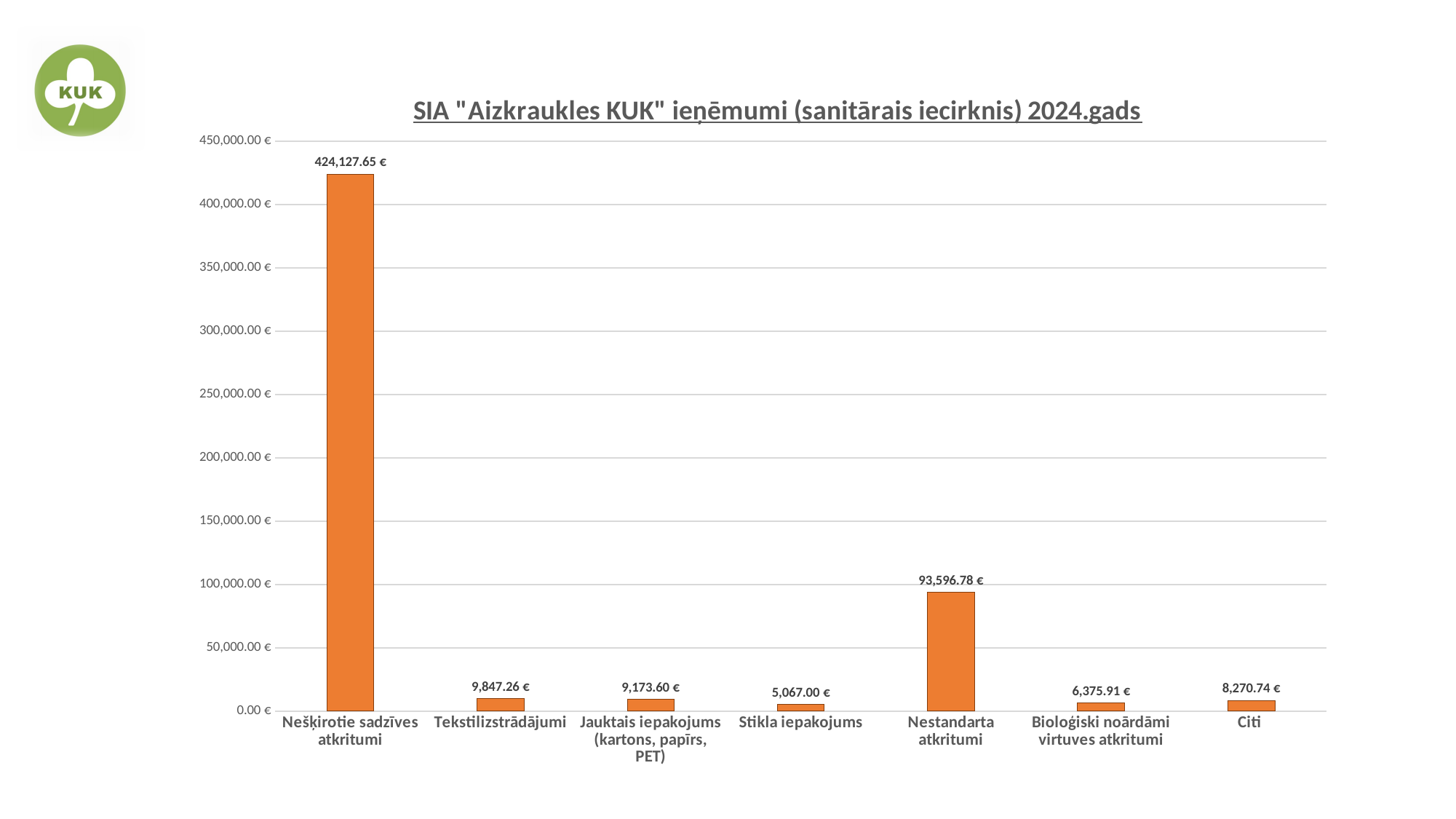
Is the value for Nestandarta atkritumi greater or less than 100,000.00 €? less How many categories are shown in the chart? 7 What is the difference between the values for Citi and Bioloģiski noārdāmi virtuves atkritumi? 1,894.83 € What is the value for Bioloģiski noārdāmi virtuves atkritumi? 6,375.91 € What is the value for Nešķirotie sadzīves atkritumi? 424,127.65 € What is the value for Stikla iepakojums? 5,067.00 € Which category has the lowest value? Stikla iepakojums Which category has the highest value? Nešķirotie sadzīves atkritumi What kind of chart is shown on the slide? bar chart What is the value for Nestandarta atkritumi? 93,596.78 € Which is larger, the value for Tekstilizstrādājumi or the value for Jauktais iepakojums (kartons, papīrs, PET)? Tekstilizstrādājumi What is the difference between the values for Nešķirotie sadzīves atkritumi and Nestandarta atkritumi? 330,530.87 €